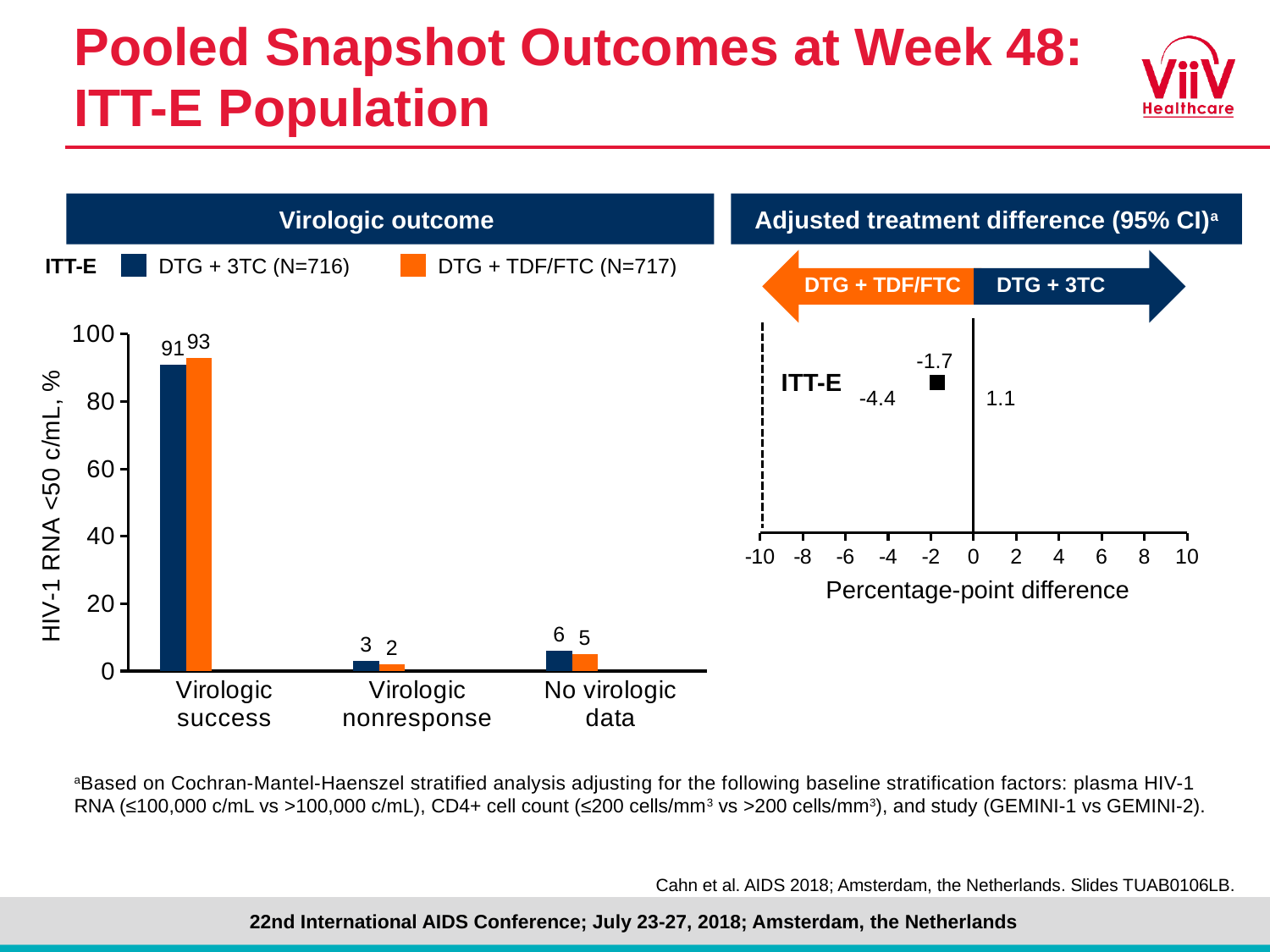
In the Virologic outcome chart, which is larger for No virologic data: DTG + 3TC or DTG + TDF/FTC? DTG + 3TC In the Adjusted treatment difference (95% CI) chart, what is the point estimate for ITT-E? -1.7 How many series does the legend of the Virologic outcome chart list? 2 In the Virologic outcome chart, what is the value for DTG + 3TC in the Virologic success category? 91 In the Virologic outcome chart, which category has the lowest value for DTG + TDF/FTC? Virologic nonresponse In the Virologic outcome chart, what is the value for DTG + 3TC in the Virologic nonresponse category? 3 In the Virologic outcome chart, what is the value for DTG + TDF/FTC in the No virologic data category? 5 In the Virologic outcome chart, what is the difference between the DTG + TDF/FTC and DTG + 3TC values for Virologic success? 2 In the Virologic outcome chart, what is the value for DTG + TDF/FTC in the Virologic success category? 93 What kind of chart is the Virologic outcome chart? Bar chart How many categories are shown on the x axis of the Virologic outcome chart? 3 In the Virologic outcome chart, which category has the highest value for DTG + 3TC? Virologic success